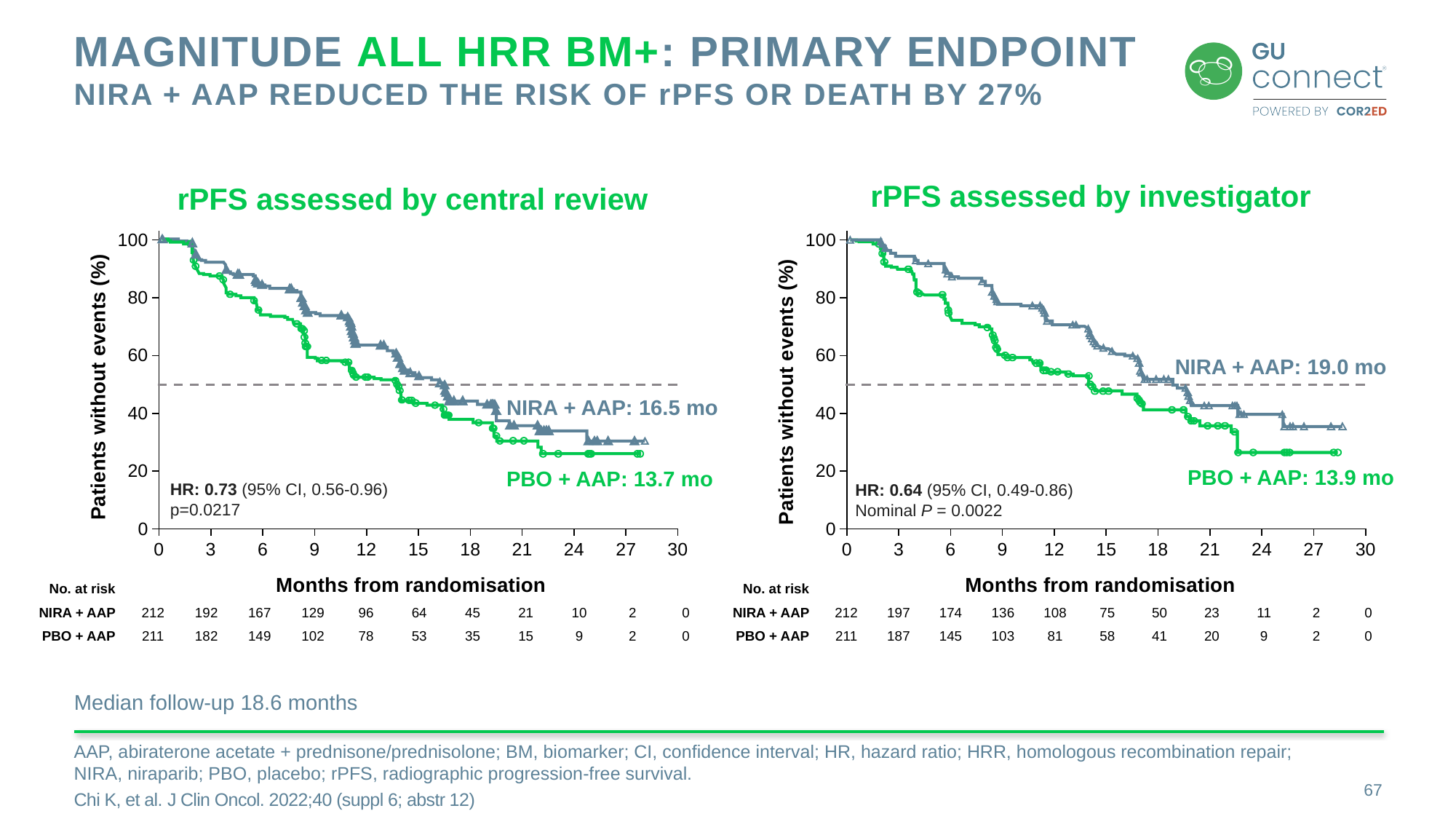
On the 'rPFS assessed by central review' chart, do the curves rise or fall as months from randomisation increase? Fall On the 'rPFS assessed by investigator' chart, which arm has the longer median rPFS, NIRA + AAP or PBO + AAP? NIRA + AAP On the 'rPFS assessed by central review' chart, how many NIRA + AAP patients were at risk at 12 months? 96 On the 'rPFS assessed by investigator' chart, what is the hazard ratio shown? 0.64 On the 'rPFS assessed by central review' chart, what is the median rPFS for PBO + AAP? 13.7 mo On the 'rPFS assessed by central review' chart, what is the median rPFS for NIRA + AAP? 16.5 mo On the 'rPFS assessed by investigator' chart, what is the median rPFS for NIRA + AAP? 19.0 mo On the 'rPFS assessed by investigator' chart, how many PBO + AAP patients were at risk at 9 months? 103 What kind of chart is 'rPFS assessed by investigator'? Line chart (Kaplan-Meier curve) On the 'rPFS assessed by central review' chart, what is the difference in median rPFS between NIRA + AAP and PBO + AAP? 2.8 mo What is the y-axis label on the 'rPFS assessed by central review' chart? Patients without events (%) On the 'rPFS assessed by central review' chart, is the value for PBO + AAP at 24 months greater or less than 40? less